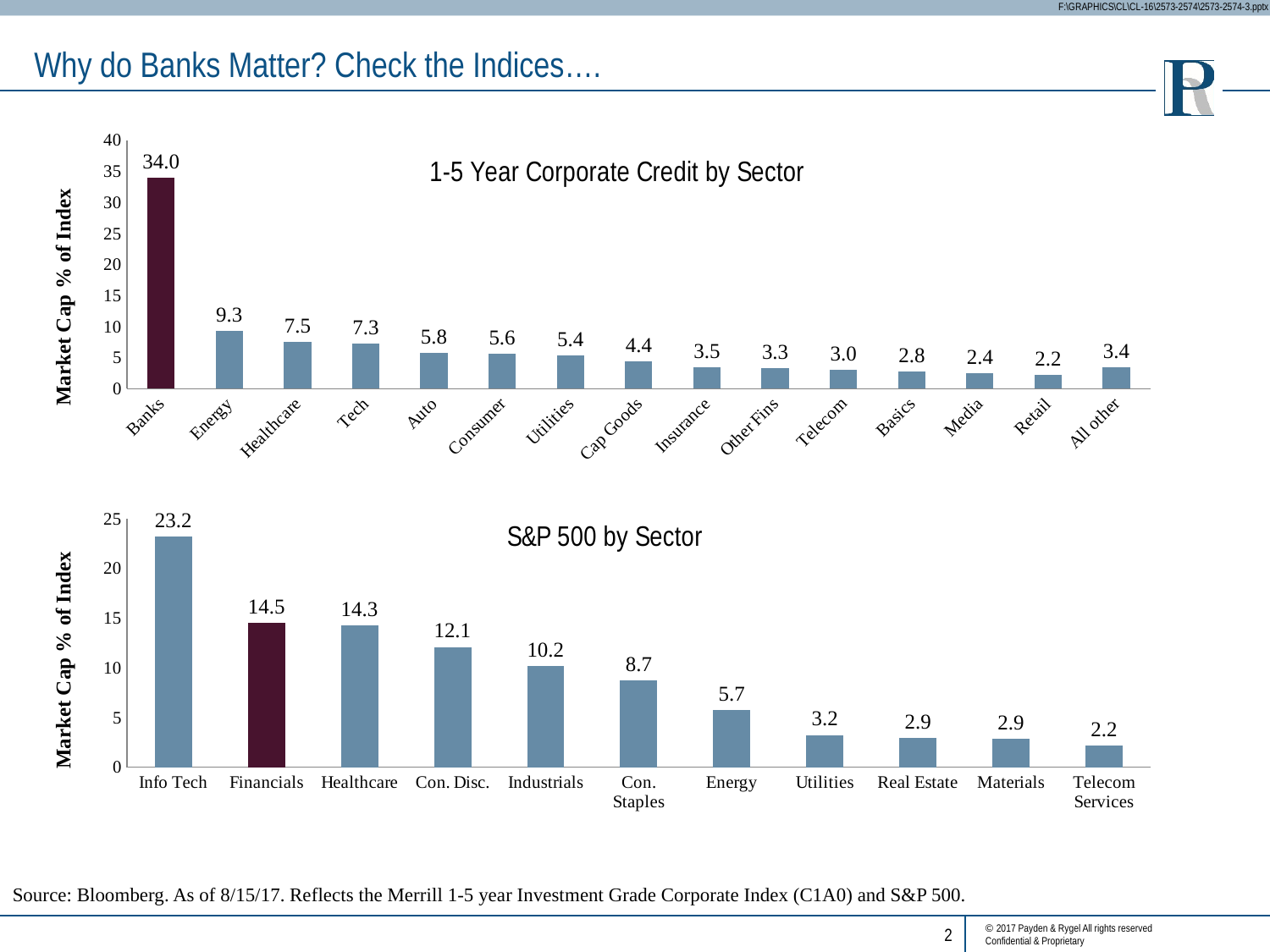
In the '1-5 Year Corporate Credit by Sector' chart, which sector has the lowest value? Retail In the '1-5 Year Corporate Credit by Sector' chart, what is the value for Banks? 34.0 In the '1-5 Year Corporate Credit by Sector' chart, which is larger, Healthcare or Tech? Healthcare In the 'S&P 500 by Sector' chart, do the values generally rise or fall from left to right? Fall In the 'S&P 500 by Sector' chart, how many sector categories are shown? 11 In the 'S&P 500 by Sector' chart, what is the difference between Info Tech and Financials? 8.7 What is the y-axis label of the '1-5 Year Corporate Credit by Sector' chart? Market Cap % of Index In the '1-5 Year Corporate Credit by Sector' chart, what is the difference between Banks and Energy? 24.7 In the '1-5 Year Corporate Credit by Sector' chart, how many sector categories are shown? 15 In the 'S&P 500 by Sector' chart, which sector has the highest value? Info Tech What type of chart is the 'S&P 500 by Sector' chart? Bar chart In the 'S&P 500 by Sector' chart, what is the value for Financials? 14.5